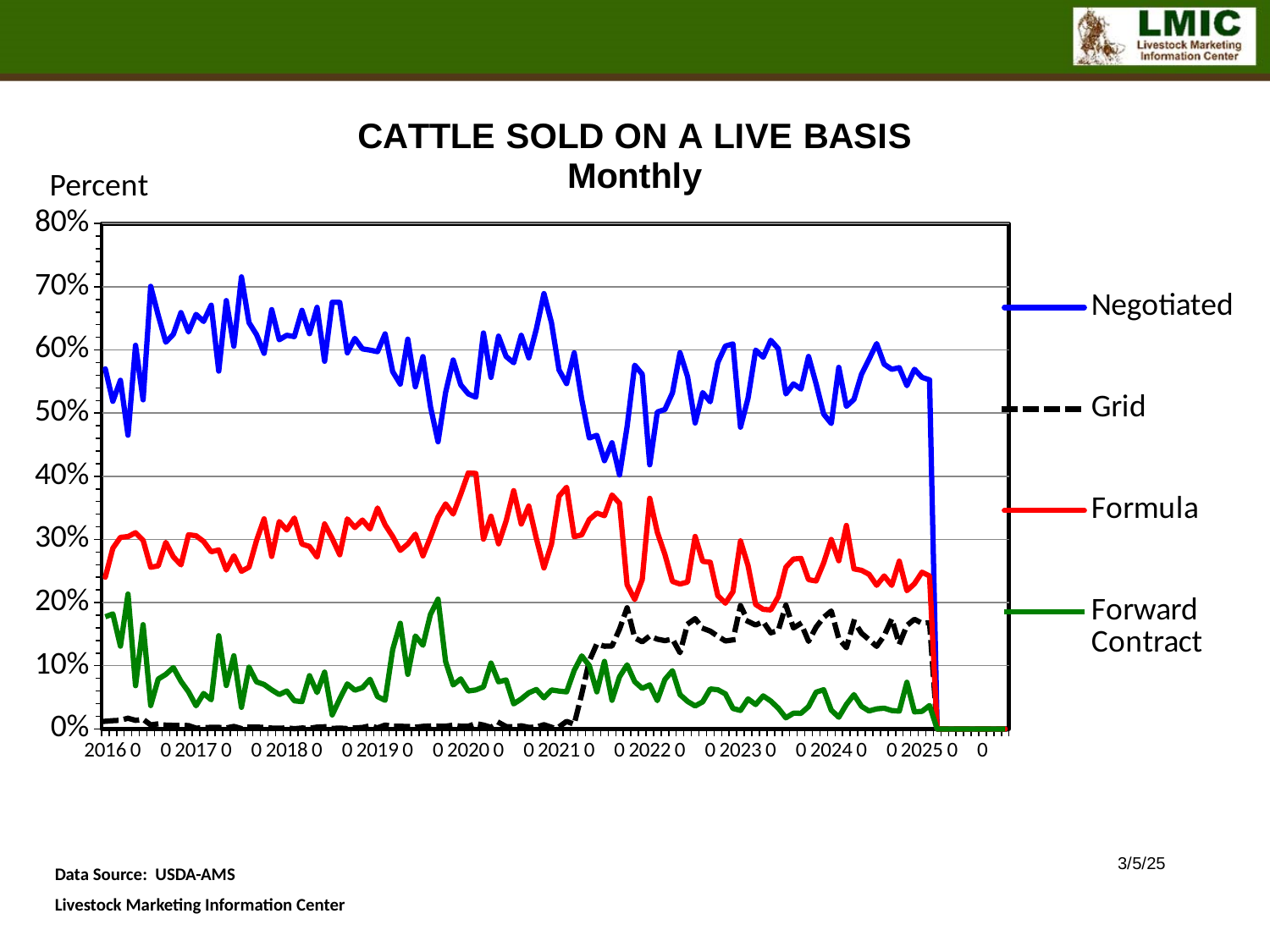
What is the title of the chart? CATTLE SOLD ON A LIVE BASIS Monthly What colour is the Negotiated line? blue Does the Grid series rise or fall from 2016 to 2023? rise Which is larger in 2016, the Forward Contract value or the Grid value? Forward Contract Is the Formula series ever greater or less than 50% over the period shown? less Which series has the lowest values in 2016? Grid Which series has the highest values across the whole period shown? Negotiated Is the peak value of the Negotiated series greater or less than 60%? greater Does the Negotiated series rise or fall from 2017 to 2021? fall What kind of chart is shown on the slide? line chart How many series does the legend list? 4 Is the Grid value in 2016 greater or less than 10%? less